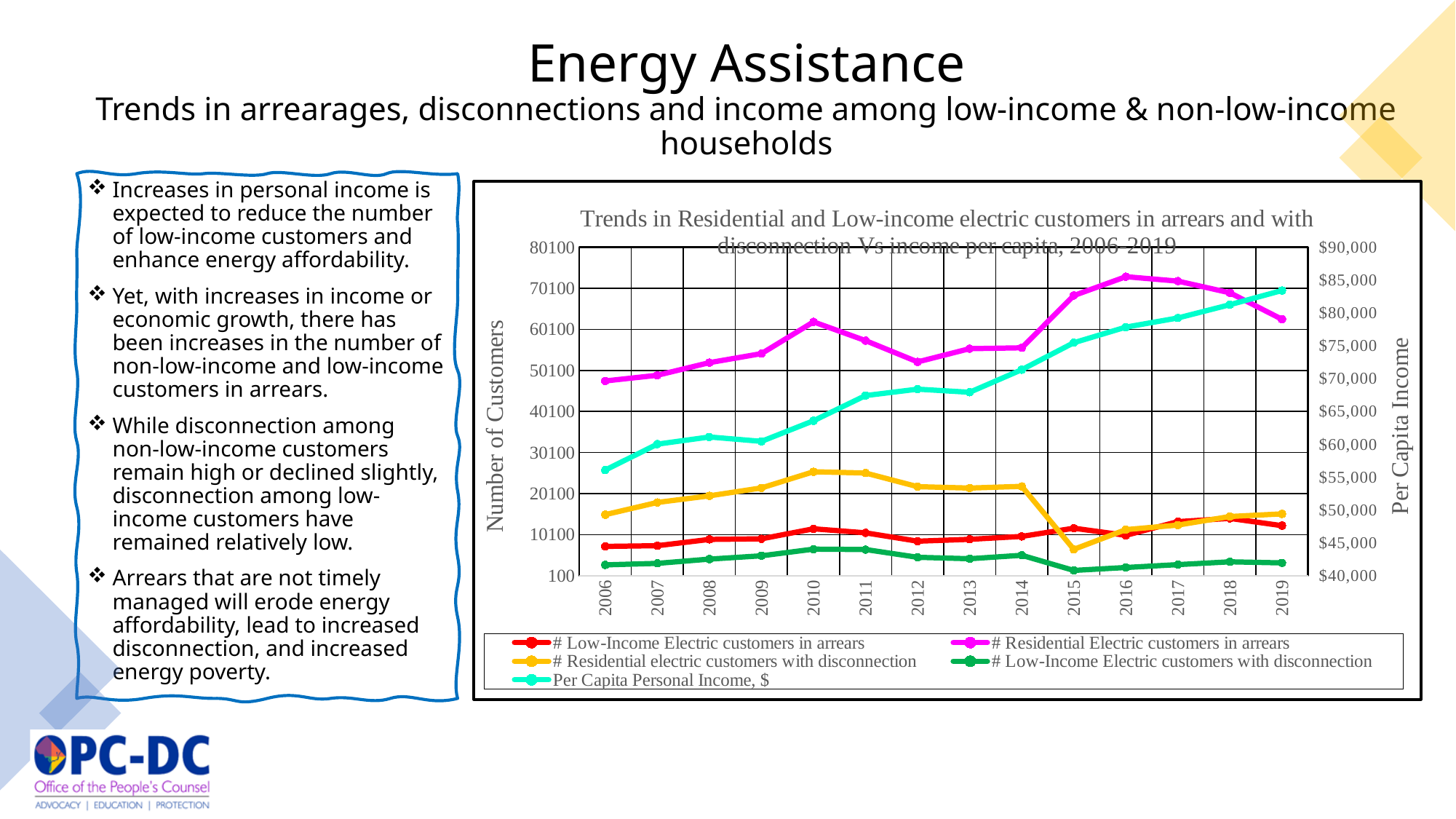
How many series does the chart's legend list? 5 Is Per Capita Personal Income in 2019 greater or less than $80,000? greater In which year is the number of Residential Electric customers in arrears highest? 2016 In which year is Per Capita Personal Income highest? 2019 How many years are plotted along the x axis of the chart? 14 Is the number of Residential electric customers with disconnection in 2015 greater or less than 10100? less What kind of chart is shown on the slide? Line chart Is the number of Residential Electric customers in arrears in 2016 greater or less than 70100? greater What is the title of the right-hand vertical axis of the chart? Per Capita Income Which is larger: the number of Residential electric customers with disconnection in 2014 or in 2015? 2014 Does Per Capita Personal Income generally rise or fall from 2006 to 2019? Rise In which year is the number of Residential electric customers with disconnection lowest? 2015